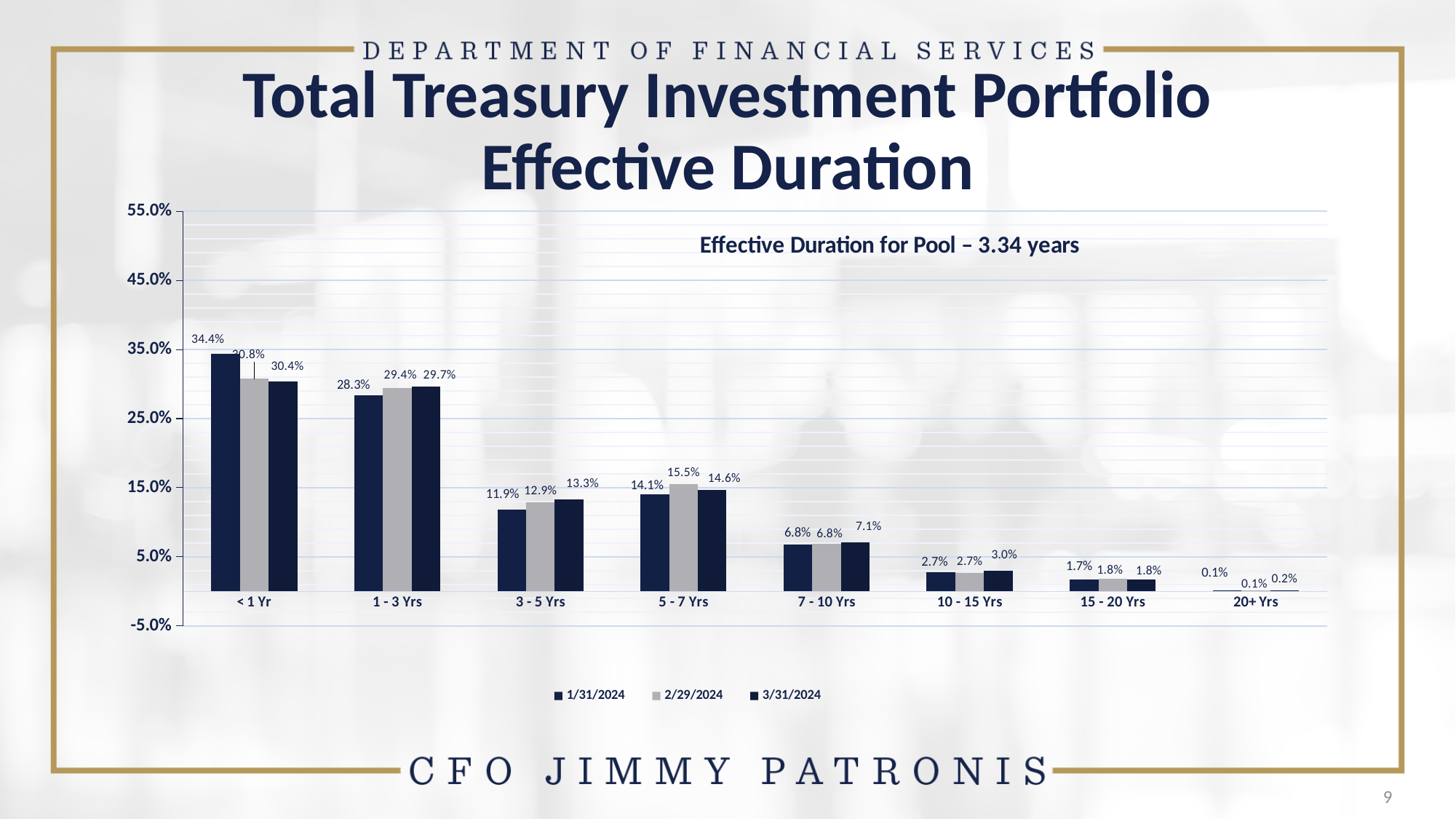
What is the difference between the 1/31/2024 and 3/31/2024 values for the < 1 Yr category? 4.0% What is the value for the < 1 Yr category in the 1/31/2024 series? 34.4% Do the values in the 3/31/2024 series generally rise or fall from the 1 - 3 Yrs category to the 20+ Yrs category? Fall What effective duration for the pool is stated on the chart? 3.34 years Which category has the lowest value in the 1/31/2024 series? 20+ Yrs How many series does the legend list? 3 What is the value for the 5 - 7 Yrs category in the 2/29/2024 series? 15.5% For the 1 - 3 Yrs category, which series has the larger value: 1/31/2024 or 3/31/2024? 3/31/2024 How many maturity categories are shown on the x axis? 8 What is the value for the 3 - 5 Yrs category in the 3/31/2024 series? 13.3% Which category has the highest value in the 3/31/2024 series? < 1 Yr What kind of chart is shown on the slide? Bar chart